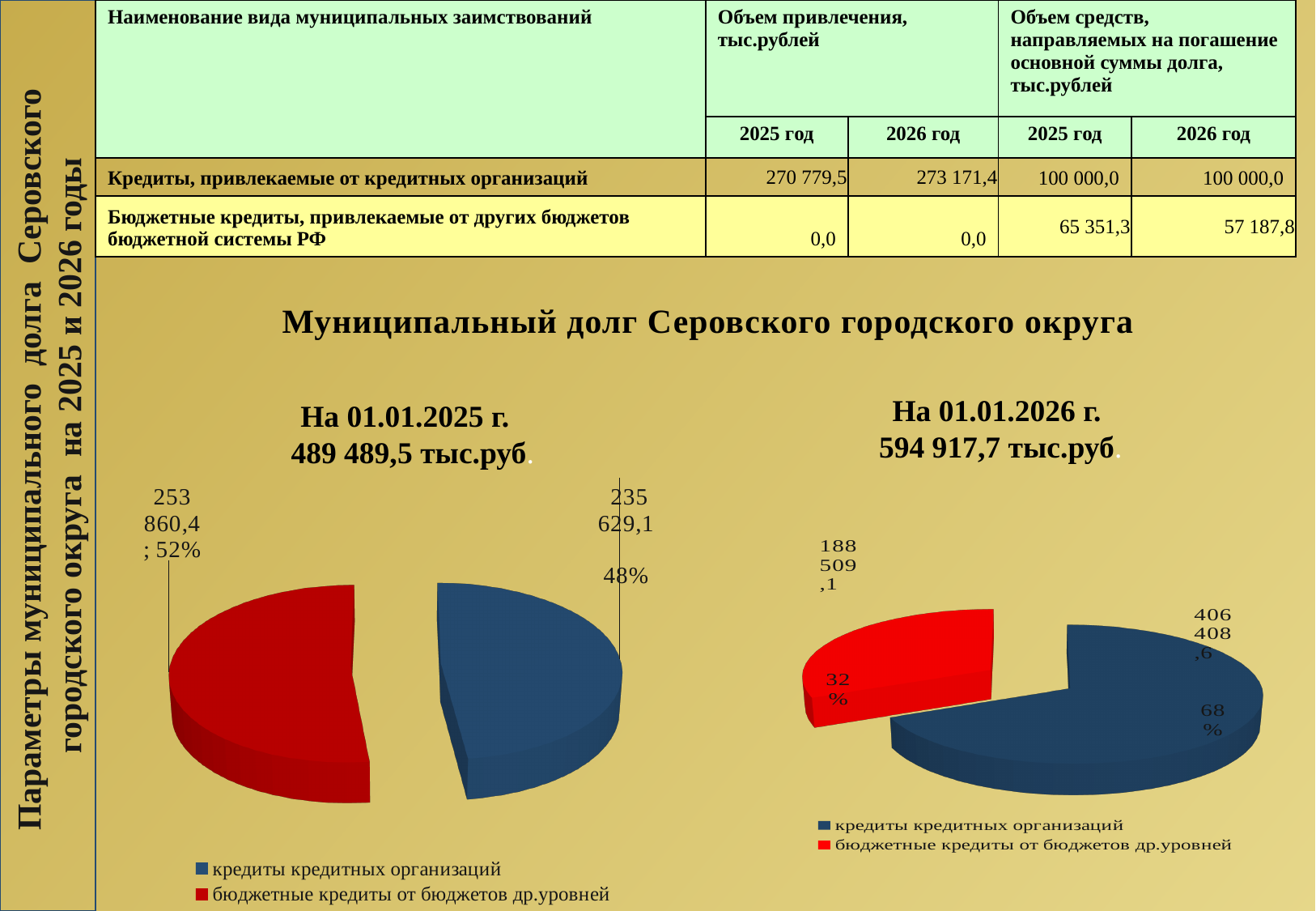
In the pie chart for 01.01.2025, what is the value for кредиты кредитных организаций? 235 629,1 In the pie chart for 01.01.2025, which category is the smallest? кредиты кредитных организаций In the pie chart for 01.01.2026, what is the value for бюджетные кредиты от бюджетов др.уровней? 188 509,1 In the pie chart for 01.01.2026, what is the difference between кредиты кредитных организаций and бюджетные кредиты от бюджетов др.уровней? 217 899,5 How many slices does the pie chart for 01.01.2025 have? 2 In the pie chart for 01.01.2026, what colour is the slice for бюджетные кредиты от бюджетов др.уровней? red In the pie chart for 01.01.2025, what is the value for бюджетные кредиты от бюджетов др.уровней? 253 860,4 What type of chart is used for the 01.01.2026 data? pie chart In the pie chart for 01.01.2026, what is the value for кредиты кредитных организаций? 406 408,6 In the pie chart for 01.01.2026, which category is the largest? кредиты кредитных организаций In the pie chart for 01.01.2026, what share of the pie is кредиты кредитных организаций? 68% In the pie chart for 01.01.2025, what share of the pie is бюджетные кредиты от бюджетов др.уровней? 52%